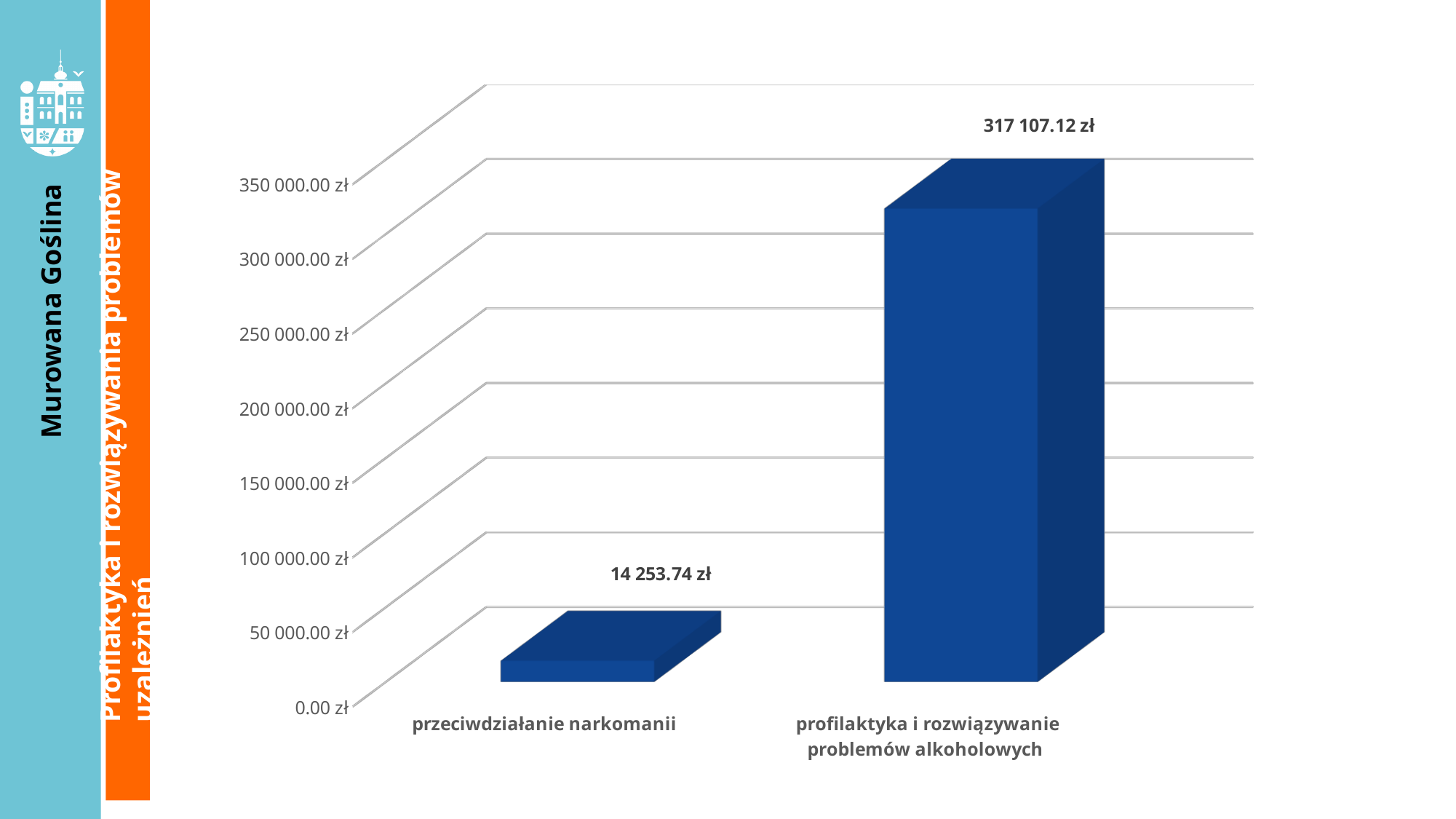
What is the value for przeciwdziałanie narkomanii? 14 253.74 zł What kind of chart is shown on the slide? bar chart Which is larger: the value for przeciwdziałanie narkomanii or the value for profilaktyka i rozwiązywanie problemów alkoholowych? profilaktyka i rozwiązywanie problemów alkoholowych What is the highest value labelled on the vertical axis? 350 000.00 zł What is the value for profilaktyka i rozwiązywanie problemów alkoholowych? 317 107.12 zł Is the value for przeciwdziałanie narkomanii greater or less than 50 000.00 zł? less Is the value for profilaktyka i rozwiązywanie problemów alkoholowych greater or less than 300 000.00 zł? greater Which category has the lowest value? przeciwdziałanie narkomanii Which category has the highest value? profilaktyka i rozwiązywanie problemów alkoholowych How many categories are shown on the chart? 2 What colour are the bars on the chart? blue What is the difference between the value for profilaktyka i rozwiązywanie problemów alkoholowych and the value for przeciwdziałanie narkomanii? 302 853.38 zł